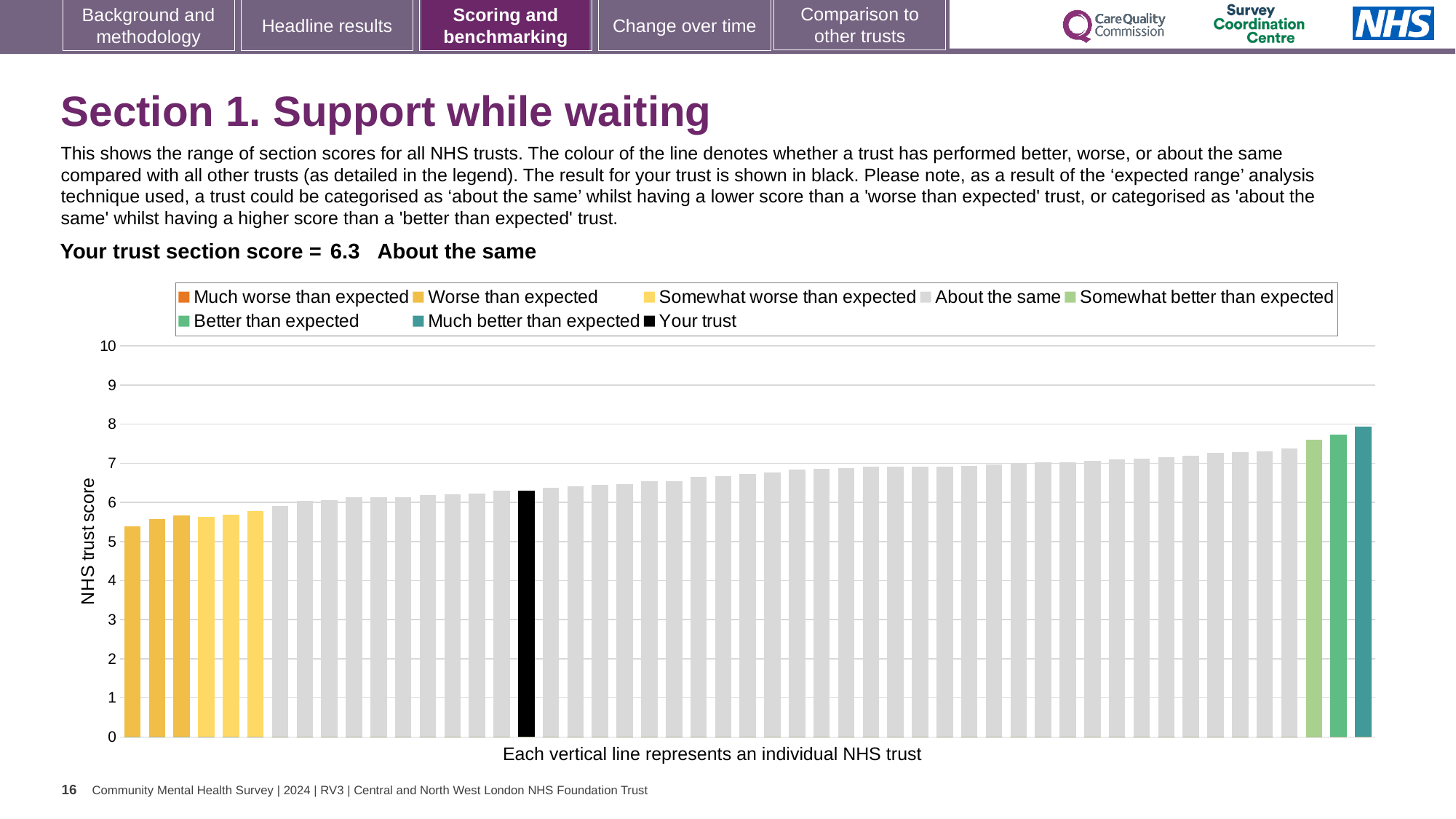
Is the value of the lowest bar in the chart greater or less than 5? greater What kind of chart is shown on the slide? bar chart How many entries does the chart legend list? 8 Which is larger: the score for your trust (black bar) or the score of the tallest bar in the chart? the tallest bar Do the bar values rise or fall from left to right along the x axis? rise Which legend category does the tallest bar in the chart belong to? Much better than expected What is the section score for your trust shown on the slide? 6.3 Which category is your trust placed in according to the slide? About the same How many bars are coloured as 'Better than expected' (green)? 1 Is the value for your trust (black bar) greater or less than 7? less What is the label on the vertical axis of the chart? NHS trust score